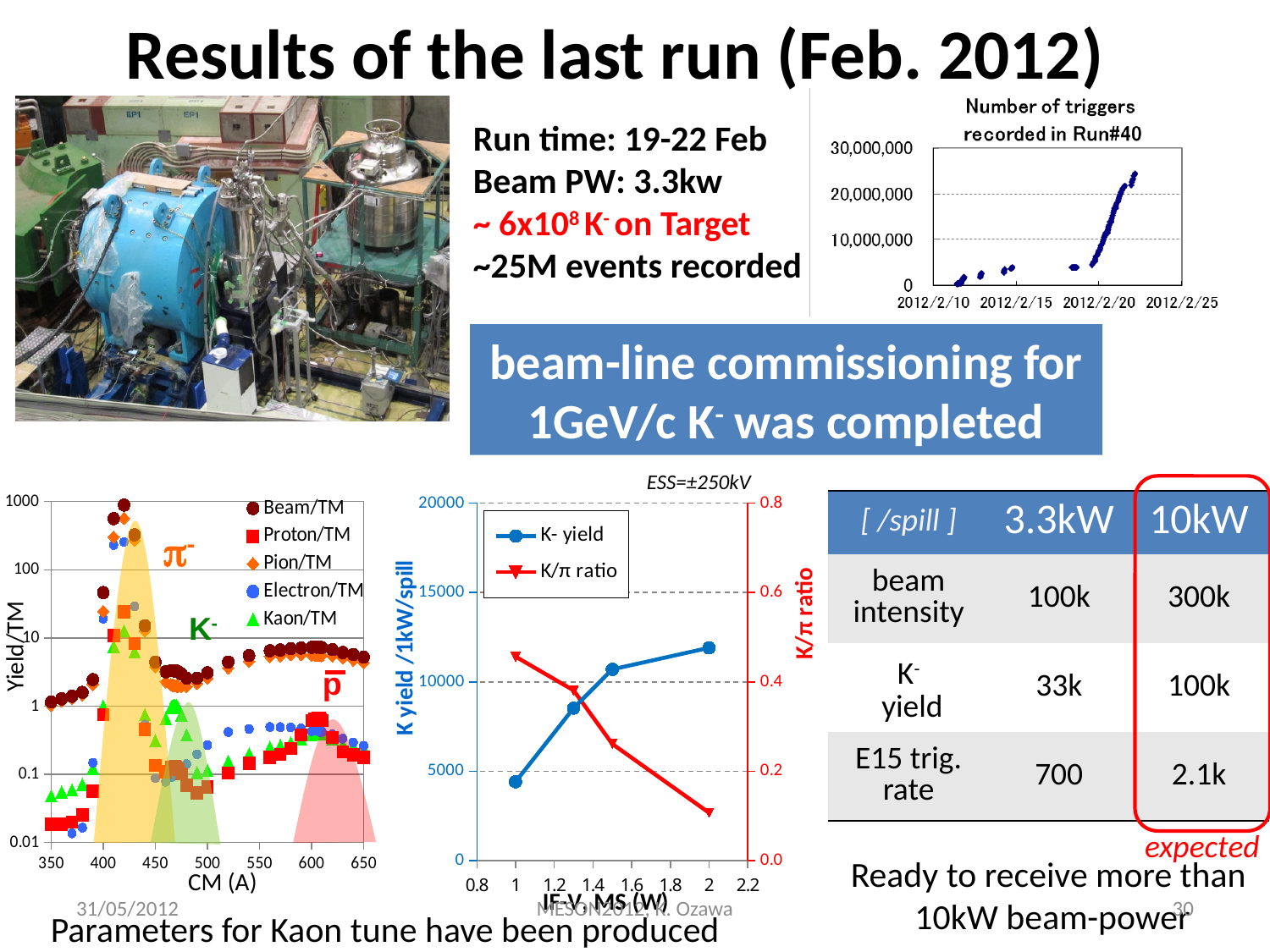
On the Yield/TM versus CM (A) chart at the bottom left, is the Beam/TM value at about 425 A greater or less than 100? greater How many series does the legend list on the K- yield chart in the bottom middle? 2 On the K- yield chart in the bottom middle, does the K/π ratio rise or fall as IF-V, MS (W) increases? fall On the Yield/TM versus CM (A) chart at the bottom left, which series reaches the highest yield near 425 A? Beam/TM On the K- yield chart in the bottom middle, does the K- yield rise or fall as IF-V, MS (W) increases? rise On the 'Number of triggers recorded in Run#40' chart, do the values rise or fall over time along the x axis? rise On the K- yield chart in the bottom middle, how many data points are plotted for the K- yield series? 4 On the 'Number of triggers recorded in Run#40' chart, is the final number of triggers greater or less than 20,000,000? greater On the K- yield chart in the bottom middle, is the K- yield at IF-V, MS = 2 W greater or less than 10000? greater How many series does the legend list on the Yield/TM versus CM (A) chart at the bottom left? 5 On the Yield/TM versus CM (A) chart at the bottom left, what is the label of the x axis? CM (A) On the 'Number of triggers recorded in Run#40' chart, what is the highest value shown on the y axis? 30,000,000